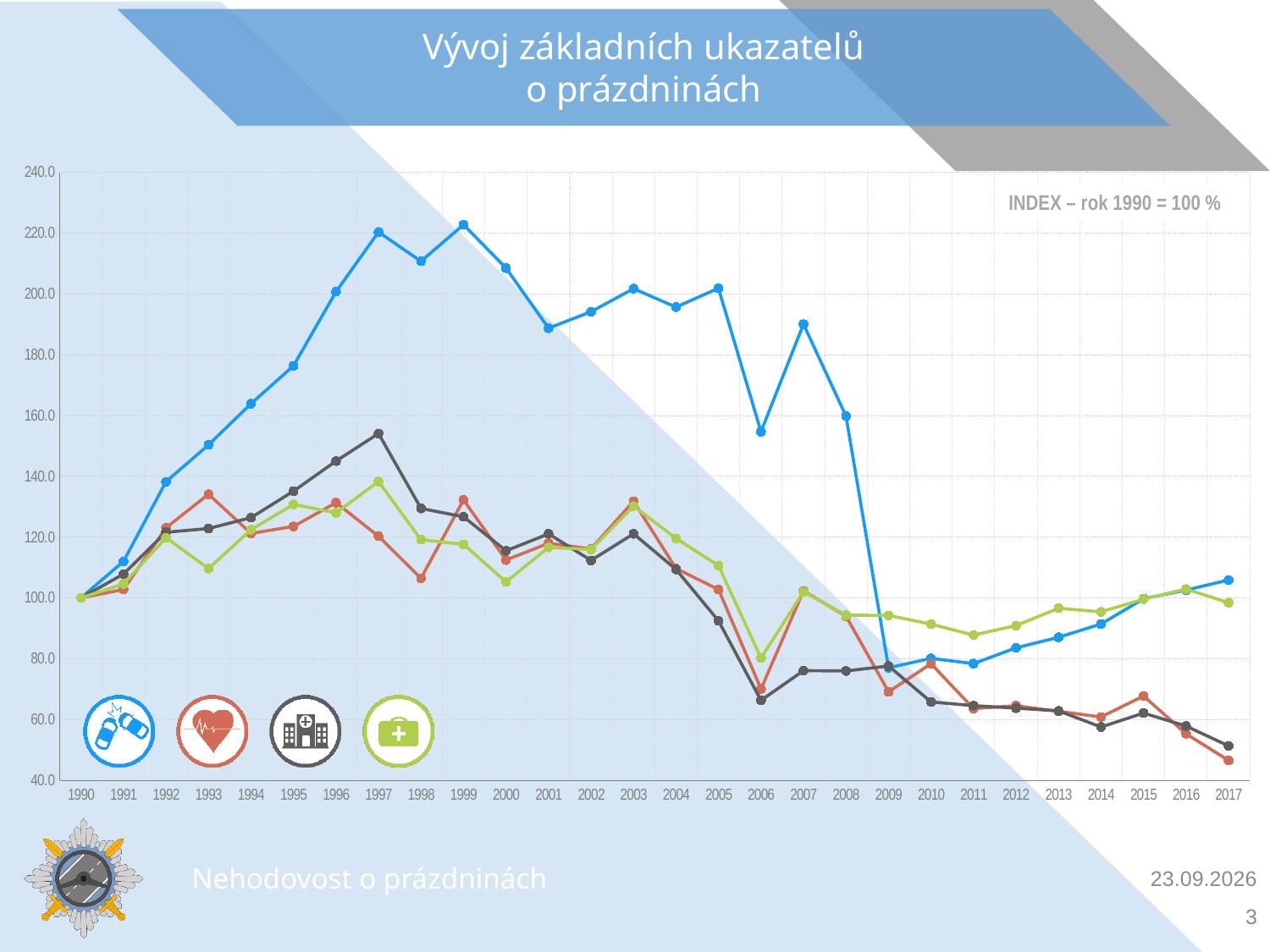
Is the value of the red line in 2017 greater or less than 60? less Which line has the highest value in 2000? the blue line How many years are shown on the x axis of the chart? 28 What is the value of the blue line in 1990? 100.0 What is the title of the chart slide? Vývoj základních ukazatelů o prázdninách Is the value of the dark grey line in 1997 greater or less than 140? greater Is the value of the green line in 2006 greater or less than 100? less How many series are plotted on the chart? 4 What kind of chart is shown on the slide? line chart Does the blue line rise or fall between 1990 and 1997? rise In 2008, which is larger: the blue line or the red line? the blue line